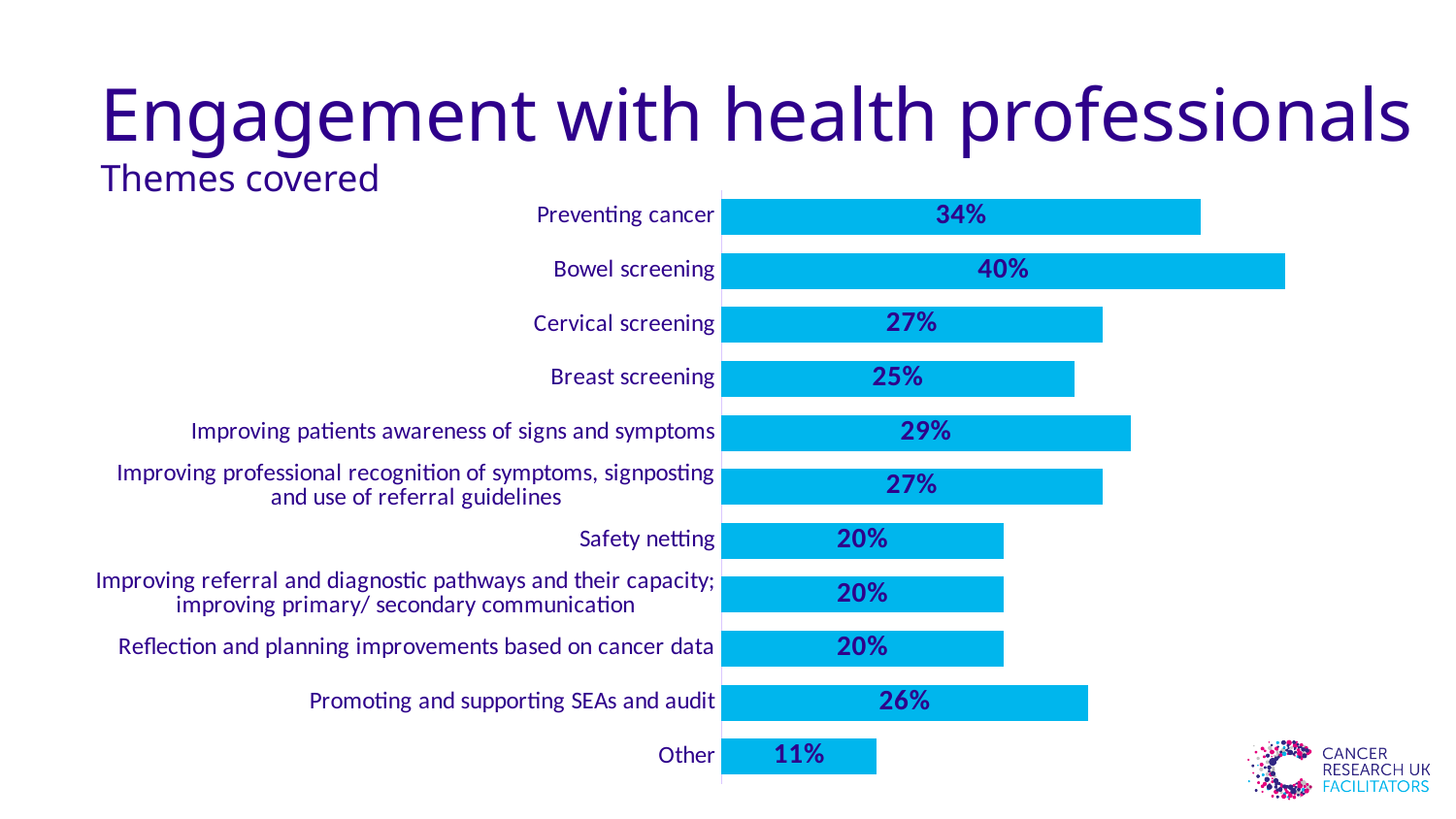
Which theme has the lowest percentage? Other What is the value for Promoting and supporting SEAs and audit? 26% What is the difference between the values for Bowel screening and Preventing cancer? 6% What kind of chart is shown on the slide? Bar chart What percentage is shown for Bowel screening? 40% Which is larger, the value for Preventing cancer or the value for Cervical screening? Preventing cancer What percentage is shown for Improving patients awareness of signs and symptoms? 29% Which theme has the highest percentage? Bowel screening What is the subtitle of the chart? Themes covered What is the value for Safety netting? 20% What is the difference between the values for Cervical screening and Breast screening? 2% How many themes are shown in the chart? 11